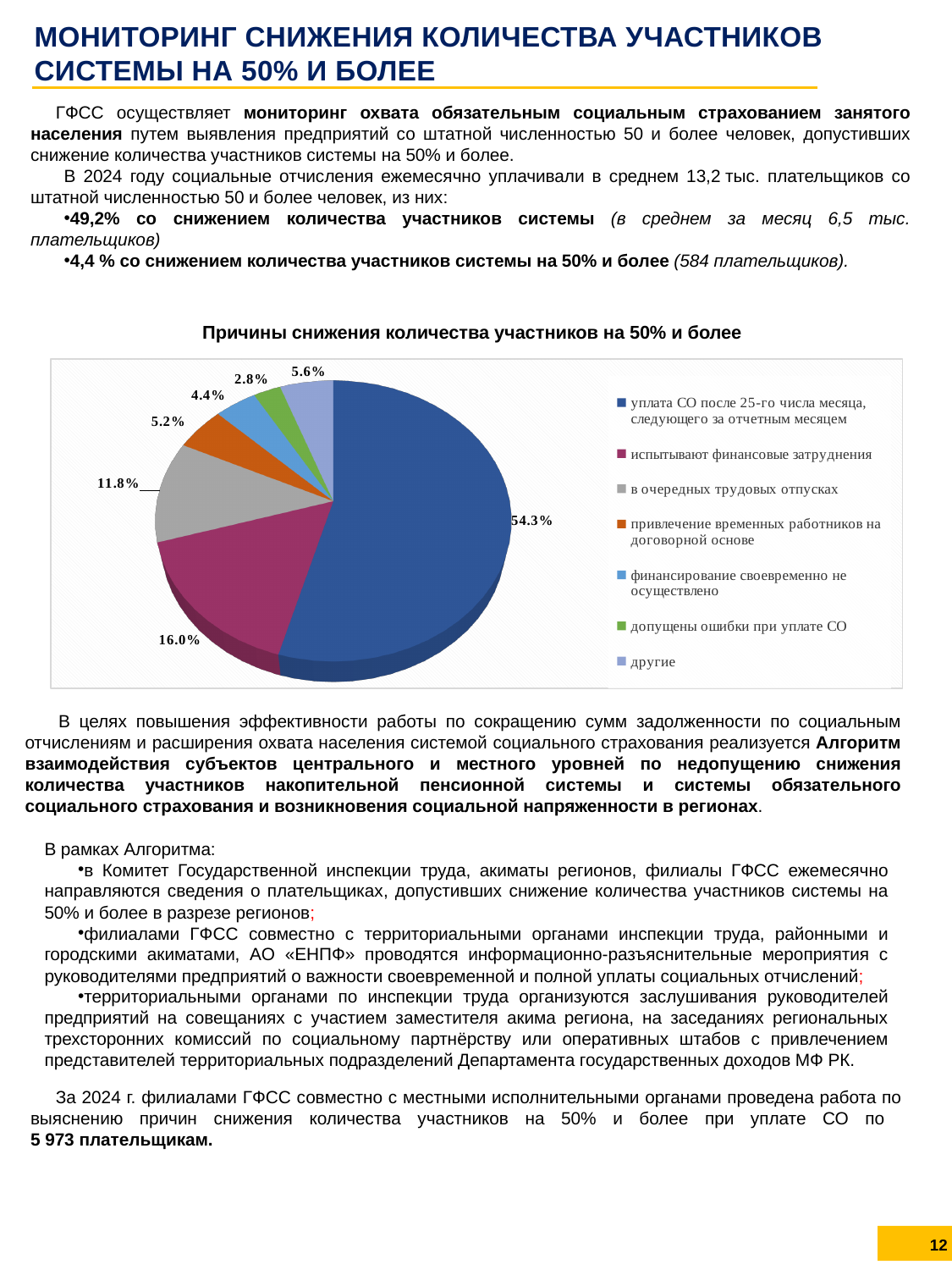
What is the title of the chart? Причины снижения количества участников на 50% и более What is the value for 'привлечение временных работников на договорной основе'? 5.2% What is the value for 'испытывают финансовые затруднения'? 16.0% What is the value for 'в очередных трудовых отпусках'? 11.8% What type of chart is shown on the slide? pie chart Which is larger: the share for 'финансирование своевременно не осуществлено' or the share for 'допущены ошибки при уплате СО'? финансирование своевременно не осуществлено Which category has the smallest share of the pie? допущены ошибки при уплате СО How many slices does the pie chart have? 7 What is the value for 'другие'? 5.6% What is the difference between the share for 'уплата СО после 25-го числа месяца, следующего за отчетным месяцем' and the share for 'испытывают финансовые затруднения'? 38.3% What share of the pie is labelled 'уплата СО после 25-го числа месяца, следующего за отчетным месяцем'? 54.3% Which category has the largest share of the pie? уплата СО после 25-го числа месяца, следующего за отчетным месяцем